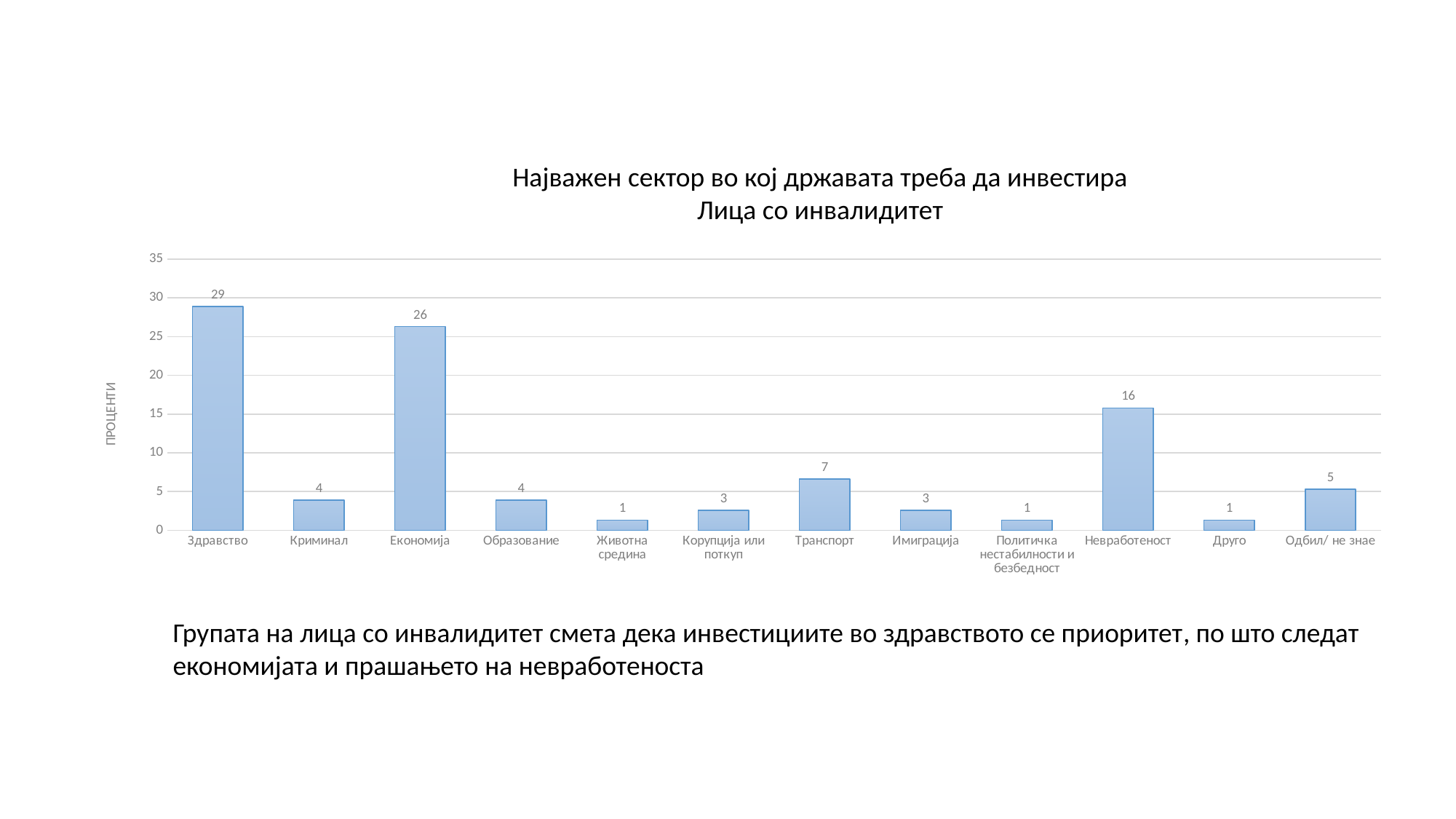
What is the label of the vertical axis? ПРОЦЕНТИ Which category has the highest value? Здравство What is the difference between the values for Невработеност and Транспорт? 9 What kind of chart is shown on the slide? bar chart Which is larger, the value for Економија or the value for Невработеност? Економија Is the value for Економија greater or less than 20? greater What is the value for Одбил/ не знае? 5 How many categories are shown on the x axis? 12 What is the value for Транспорт? 7 What is the value for Невработеност? 16 What is the value for Здравство? 29 What is the difference between the values for Здравство and Економија? 3